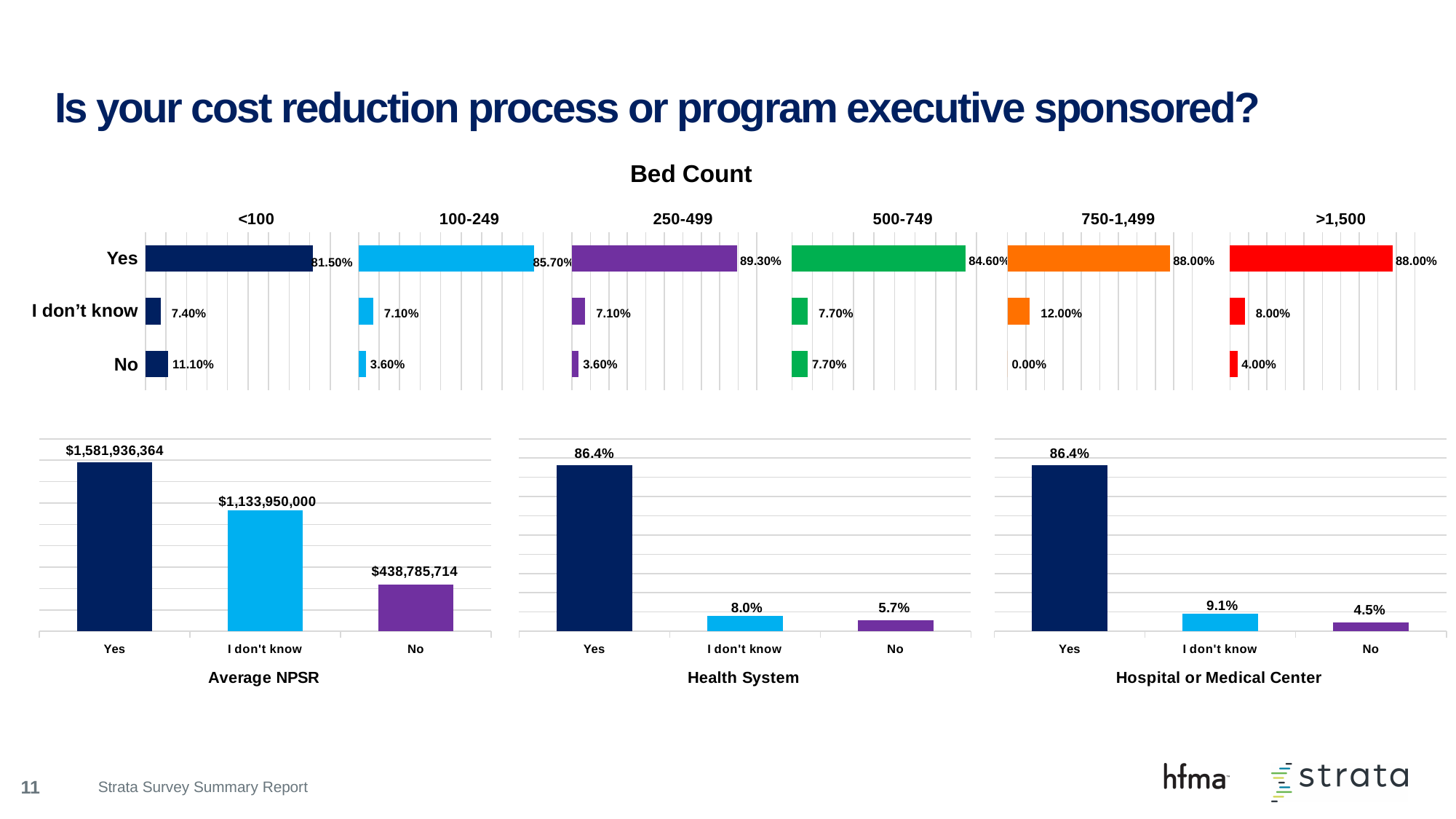
Which is larger: the I don't know value in the Health System chart or in the Hospital or Medical Center chart? Hospital or Medical Center In the Average NPSR chart, what is the value for I don't know? $1,133,950,000 What type of chart is the Average NPSR chart? Bar chart In the Bed Count chart, what is the value for Yes in the 250-499 bed group? 89.30% In the Bed Count chart, which bed group has the highest Yes value? 250-499 In the Bed Count chart, which bed group has the lowest Yes value? <100 In the Bed Count chart, what is the difference between the Yes values for 100-249 and <100 beds? 4.20% In the Hospital or Medical Center chart, what is the difference between I don't know and No? 4.6% In the Bed Count chart, what is the value for No in the 750-1,499 bed group? 0.00% In the Bed Count chart, how many bed count groups are shown? 6 In the Average NPSR chart, which category has the lowest value? No In the Health System chart, what is the value for No? 5.7%